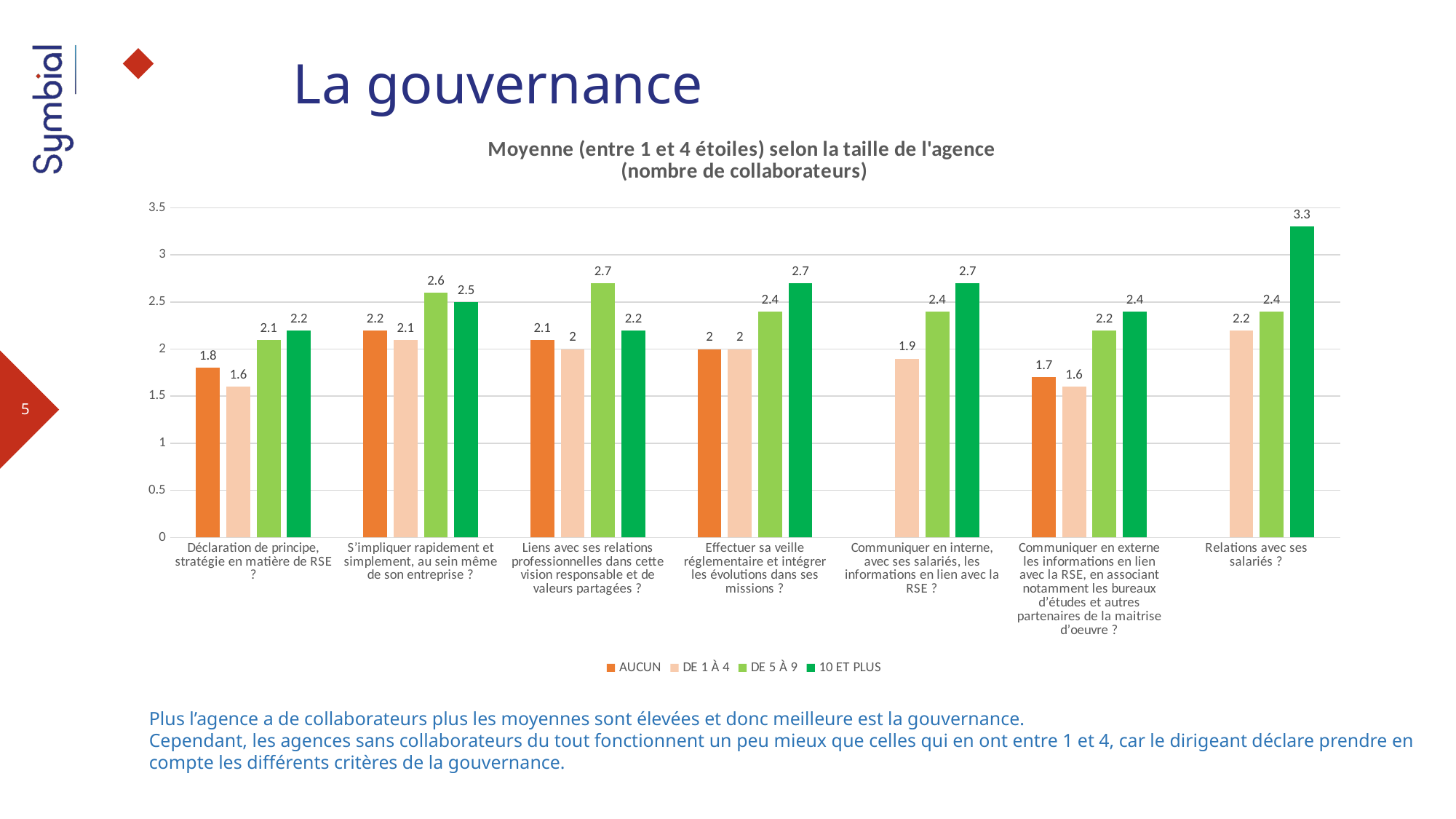
What is the value for 'AUCUN' in the category 'Déclaration de principe, stratégie en matière de RSE ?'? 1.8 What is the title of the chart? Moyenne (entre 1 et 4 étoiles) selon la taille de l'agence (nombre de collaborateurs) What kind of chart is shown on the slide? Bar chart What is the difference between the '10 ET PLUS' and 'DE 1 À 4' values in the category 'Relations avec ses salariés ?'? 1.1 Which category has the highest value for the '10 ET PLUS' series? Relations avec ses salariés ? How many categories are shown on the x axis? 7 What is the value for 'DE 1 À 4' in the category 'Communiquer en interne, avec ses salariés, les informations en lien avec la RSE ?'? 1.9 How many series does the legend list? 4 What is the value for 'DE 5 À 9' in the category 'S'impliquer rapidement et simplement, au sein même de son entreprise ?'? 2.6 Which category has the lowest value for the 'AUCUN' series? Communiquer en externe les informations en lien avec la RSE, en associant notamment les bureaux d'études et autres partenaires de la maitrise d'oeuvre ? In the category 'S'impliquer rapidement et simplement, au sein même de son entreprise ?', which is larger: 'DE 5 À 9' or '10 ET PLUS'? DE 5 À 9 What is the value for '10 ET PLUS' in the category 'Relations avec ses salariés ?'? 3.3